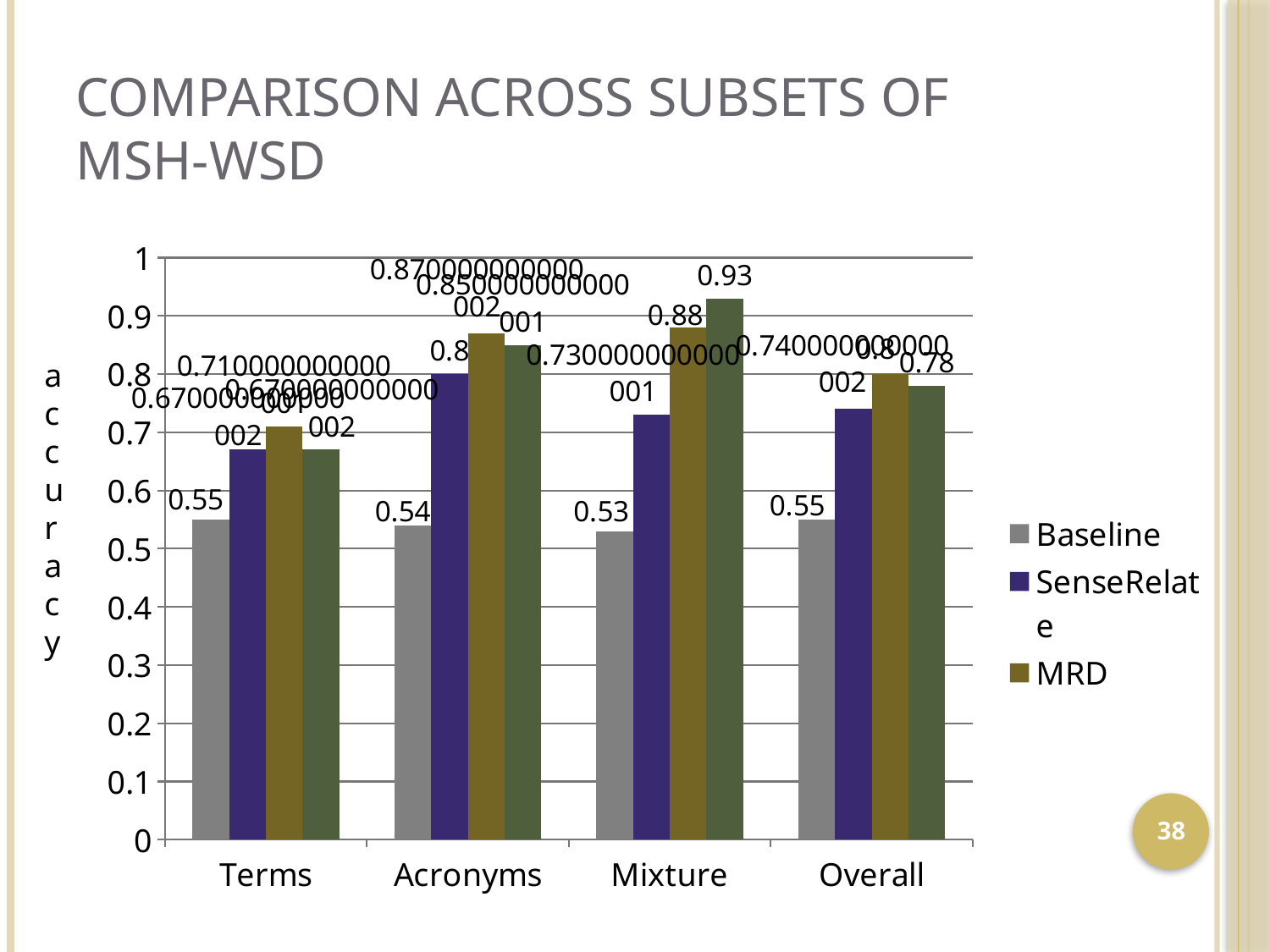
How many categories are shown on the x axis? 4 For which category is the Baseline accuracy lowest? Mixture What is the Baseline accuracy for Mixture? 0.53 What kind of chart is shown on the slide? bar chart What is the MRD accuracy for Mixture? 0.88 How many series does the legend list? 3 What is the SenseRelate accuracy for Acronyms? 0.8 Which is larger, the Baseline accuracy for Terms or for Acronyms? Terms Is the SenseRelate accuracy for Overall greater or less than 0.7? greater What is the difference between the MRD and Baseline accuracy for Mixture? 0.35 What is the Baseline accuracy for Terms? 0.55 What is the MRD accuracy for Overall? 0.8